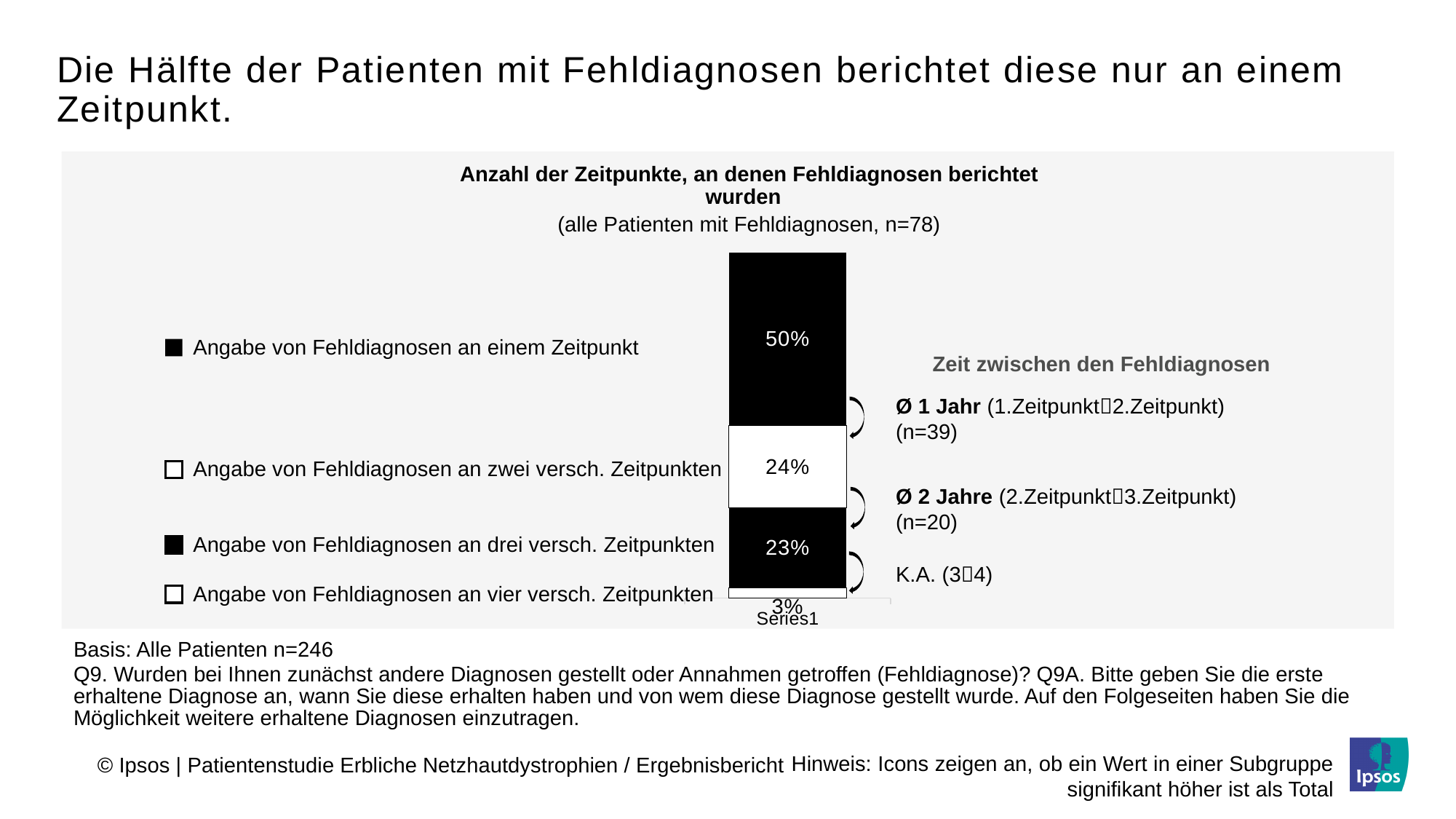
What type of chart is shown on the slide? Stacked bar chart Which segment of the stacked bar has the largest share? Angabe von Fehldiagnosen an einem Zeitpunkt What is the total of all segments in the stacked bar? 100% What percentage of patients reported misdiagnoses at three different points in time (an drei versch. Zeitpunkten)? 23% Which is larger: the share for two different points in time or the share for three different points in time? Two different points in time (24%) What percentage of patients reported misdiagnoses at one point in time (Angabe von Fehldiagnosen an einem Zeitpunkt)? 50% What percentage of patients reported misdiagnoses at two different points in time (an zwei versch. Zeitpunkten)? 24% What percentage of patients reported misdiagnoses at four different points in time (an vier versch. Zeitpunkten)? 3% What is the title of the chart? Anzahl der Zeitpunkte, an denen Fehldiagnosen berichtet wurden What is the difference in percentage points between misdiagnoses reported at one point in time and at two different points in time? 26 percentage points How many segments (legend entries) does the stacked bar chart have? 4 Which segment of the stacked bar has the smallest share? Angabe von Fehldiagnosen an vier versch. Zeitpunkten